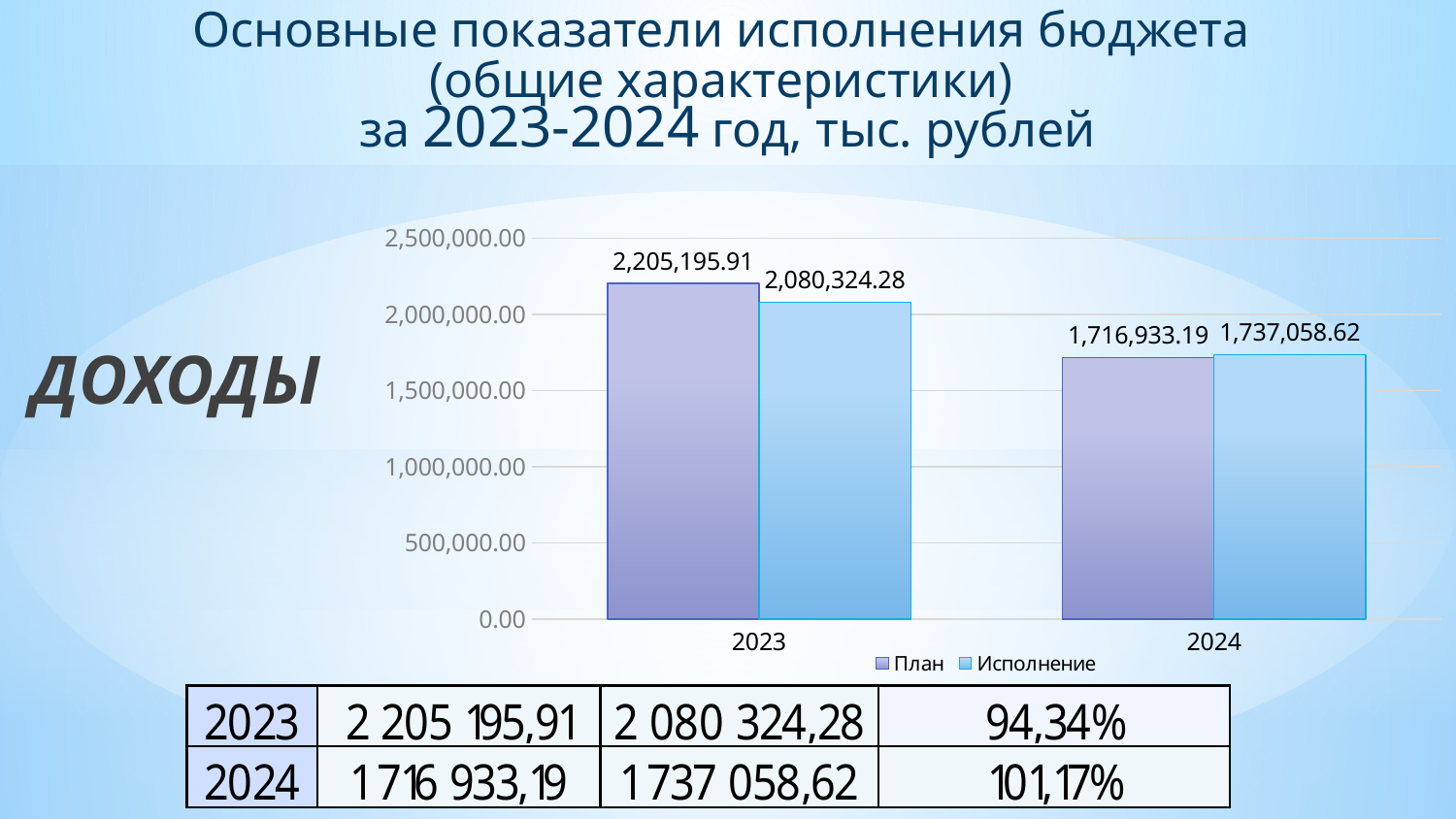
Which bar has the lowest value in the chart? План 2024 Does the План series rise or fall from 2023 to 2024? fall What is the value of План for 2024? 1,716,933.19 What is the value of Исполнение for 2023? 2,080,324.28 How many series does the legend list? 2 Is the value of Исполнение for 2023 greater or less than 2,000,000.00? greater What is the difference between План and Исполнение for 2023? 124,871.63 What type of chart is shown on the slide? bar chart What is the value of План for 2023? 2,205,195.91 Which bar has the highest value in the chart? План 2023 What is the value of Исполнение for 2024? 1,737,058.62 Which is larger for 2024, План or Исполнение? Исполнение